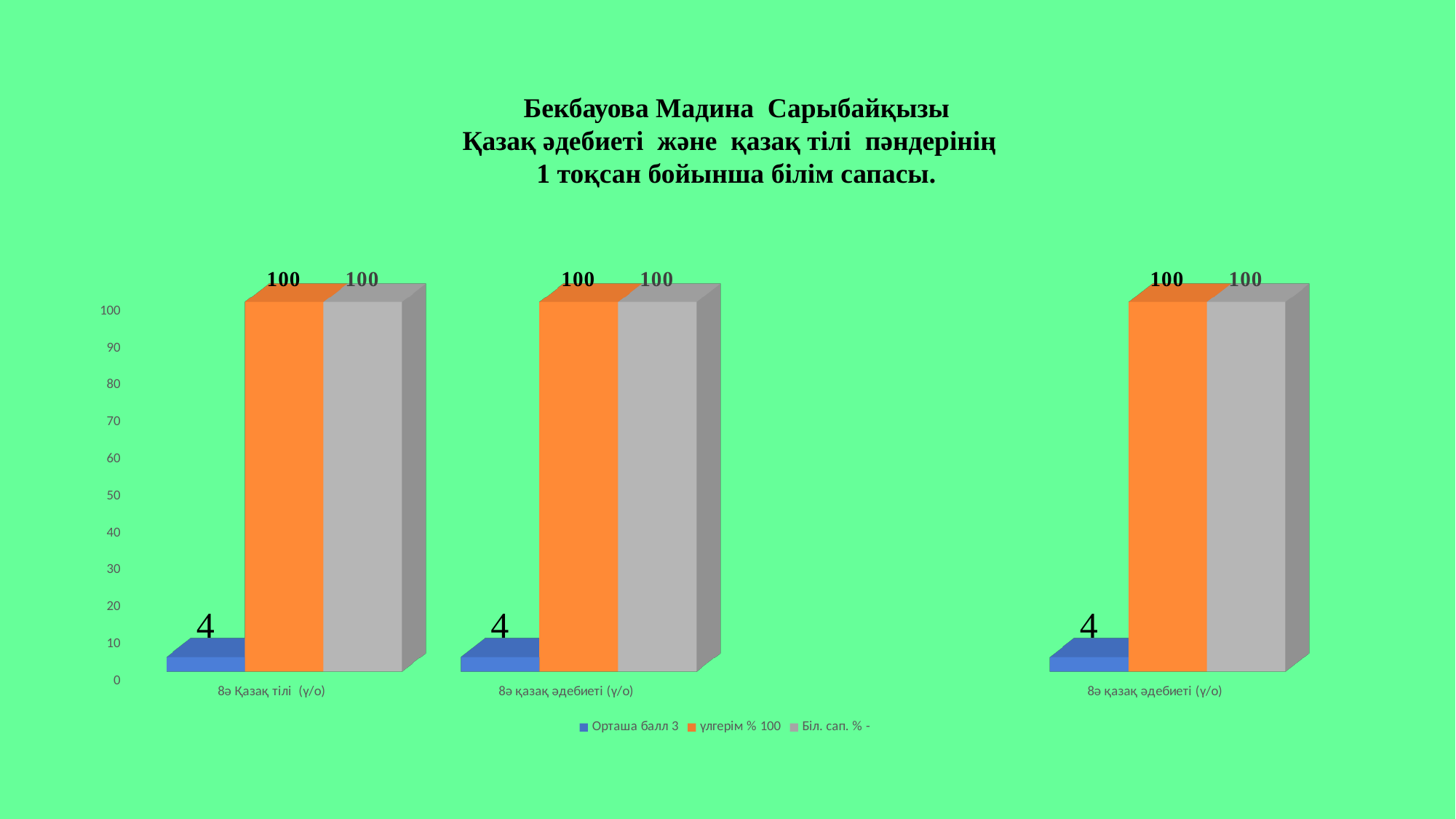
What is the difference between the "үлгерім % 100" value and the "Орташа балл 3" value for "8ә Қазақ тілі (ү/о)"? 96 For "8ә Қазақ тілі (ү/о)", which is larger: the "Орташа балл 3" value or the "үлгерім % 100" value? үлгерім % 100 How many series does the legend list? 3 What kind of chart is shown on the slide? bar chart What is the value of the "Біл. сап. % -" series for the middle category, "8ә қазақ әдебиеті (ү/о)"? 100 What colour are the bars of the "үлгерім % 100" series? orange What is the highest value shown on the vertical axis? 100 What is the value of the "Орташа балл 3" series for "8ә Қазақ тілі (ү/о)"? 4 How many categories are shown on the x axis? 3 What is the value of the "үлгерім % 100" series for "8ә Қазақ тілі (ү/о)"? 100 Which series has the lowest value for "8ә Қазақ тілі (ү/о)"? Орташа балл 3 Is the "Орташа балл 3" value for "8ә Қазақ тілі (ү/о)" greater or less than 10? less